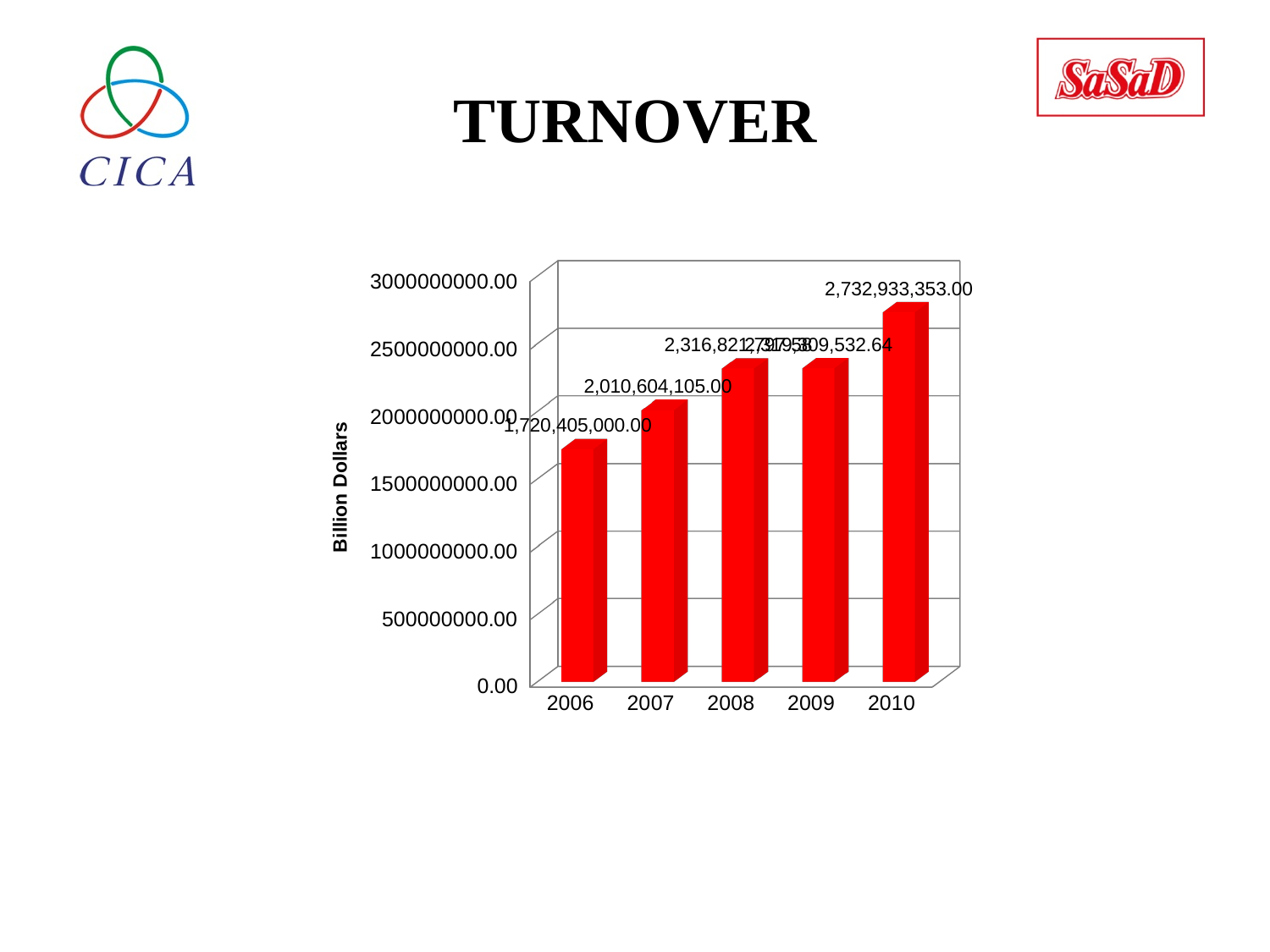
How many years are shown on the x axis? 5 What is the turnover value for 2007? 2,010,604,105.00 What is the turnover value for 2006? 1,720,405,000.00 Which year has the highest turnover? 2010 Is the value for 2006 greater or less than 2000000000.00? less Is the value for 2008 greater or less than 2500000000.00? less Which year has the larger turnover, 2007 or 2010? 2010 What is the turnover value for 2010? 2,732,933,353.00 What kind of chart is shown on the slide? bar chart What is the label on the vertical axis? Billion Dollars Which year has the lowest turnover? 2006 What is the difference between the turnover in 2010 and in 2006? 1,012,528,353.00